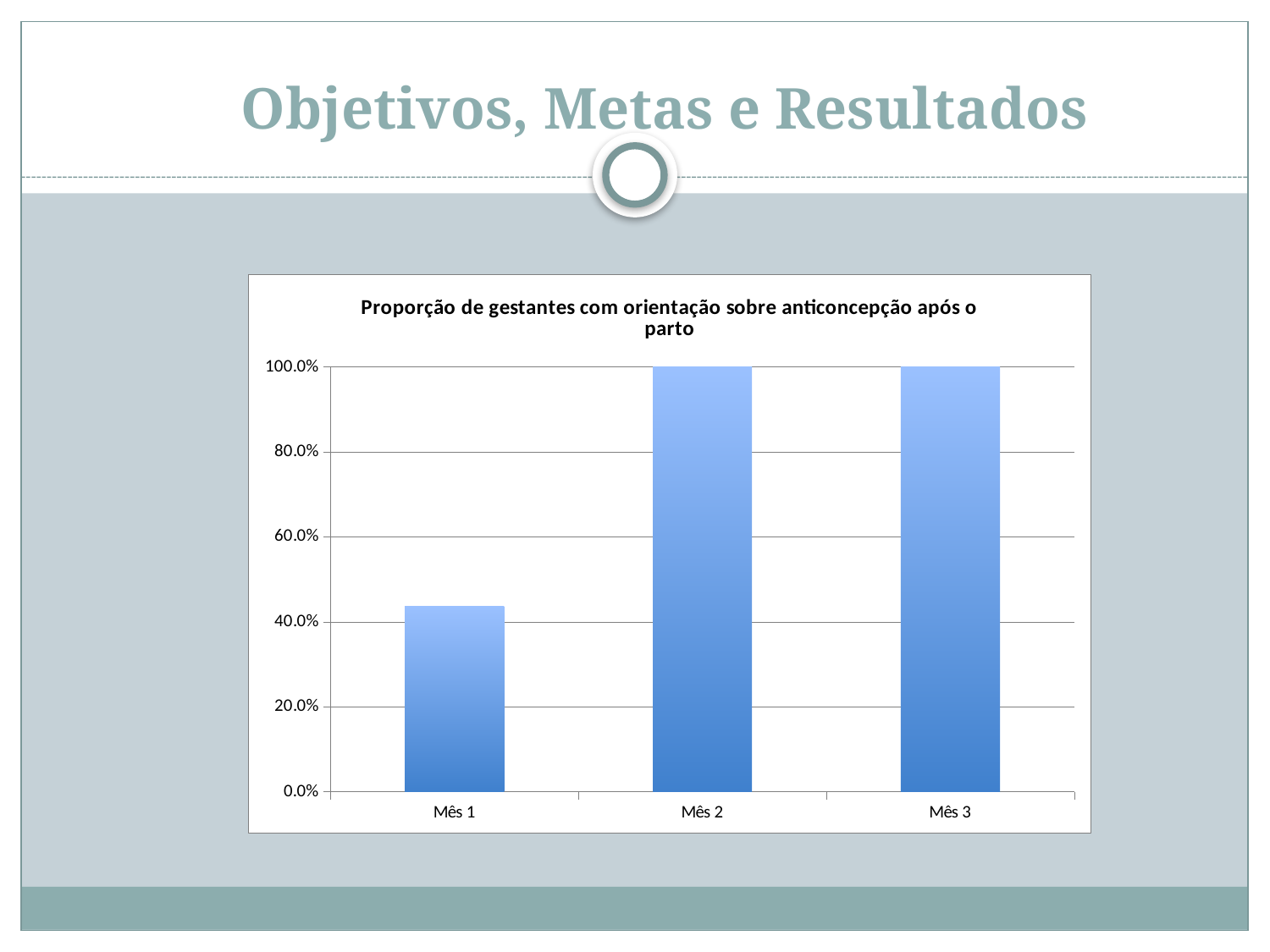
What is the title of the chart? Proporção de gestantes com orientação sobre anticoncepção após o parto What is the value for Mês 3? 100.0% Which is larger, the value for Mês 1 or the value for Mês 2? Mês 2 What kind of chart is shown on the slide? bar chart Is the value for Mês 1 greater or less than 40.0%? greater Do the values rise or fall from Mês 1 to Mês 2? rise Which is larger, the value for Mês 3 or the value for Mês 1? Mês 3 Is the value for Mês 1 greater or less than 60.0%? less What is the value for Mês 2? 100.0% How many categories are shown on the x axis of the chart? 3 Which month has the lowest value? Mês 1 What is the highest value shown on the y axis of the chart? 100.0%